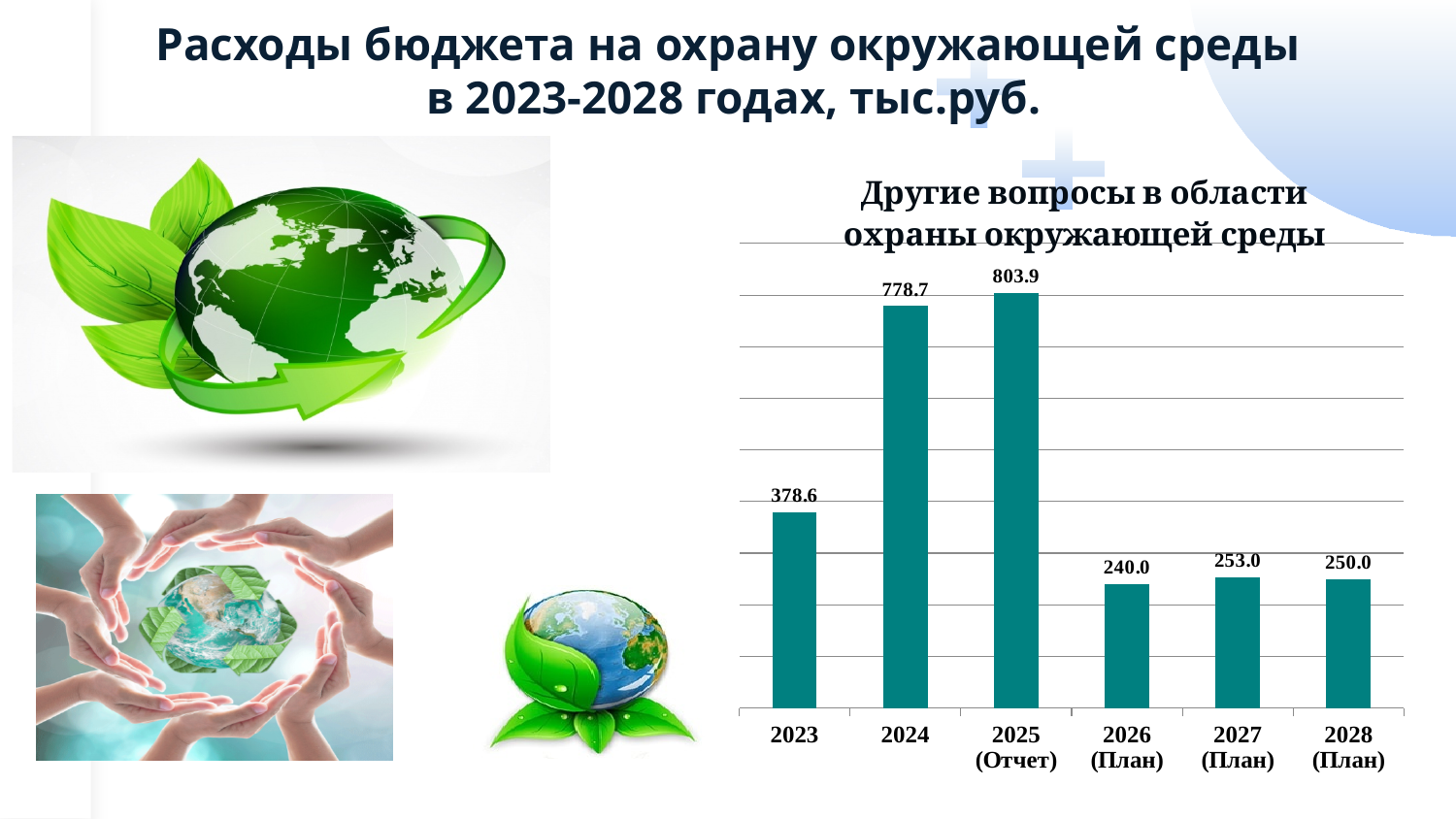
What is the value for 2023? 378.6 What is the title of the chart? Другие вопросы в области охраны окружающей среды What is the value for 2028 (План)? 250.0 Which year has the lowest value? 2026 (План) Which year has the highest value? 2025 (Отчет) What kind of chart is this? bar chart Which is larger, the value for 2027 (План) or the value for 2026 (План)? 2027 (План) What is the difference between the values for 2024 and 2023? 400.1 What is the value for 2025 (Отчет)? 803.9 What is the value for 2027 (План)? 253.0 How many years are shown on the x axis? 6 What is the difference between the values for 2025 (Отчет) and 2024? 25.2